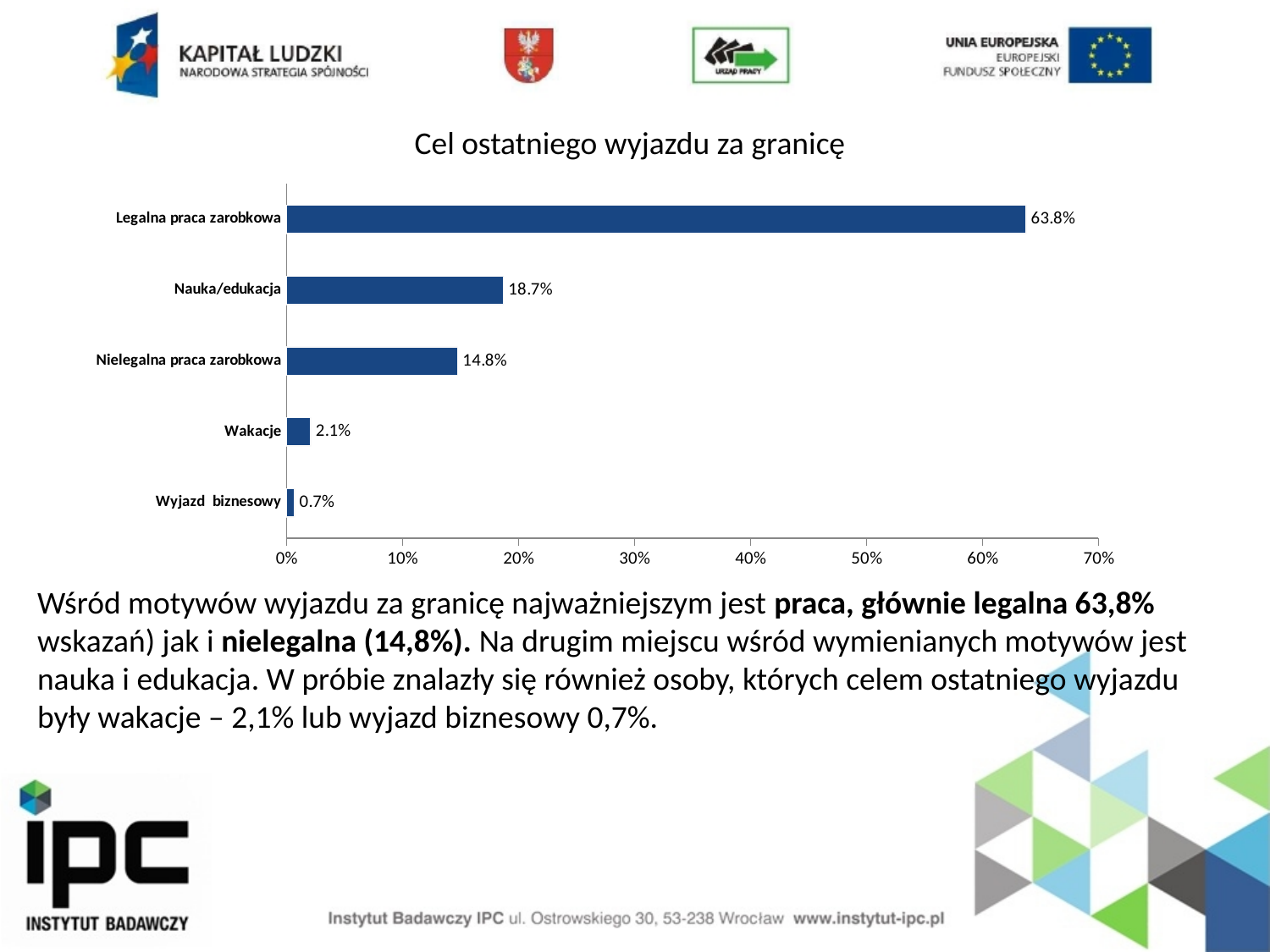
What is the value for Nauka/edukacja? 18.7% What kind of chart is shown? bar chart What is the title of the chart? Cel ostatniego wyjazdu za granicę What is the difference between Nauka/edukacja and Nielegalna praca zarobkowa? 3.9% Is the value for Legalna praca zarobkowa greater or less than 60%? greater Which category has the highest value? Legalna praca zarobkowa How many categories are shown in the chart? 5 What is the value for Legalna praca zarobkowa? 63.8% What is the value for Wakacje? 2.1% Which category has the lowest value? Wyjazd biznesowy Which is larger, Nielegalna praca zarobkowa or Wakacje? Nielegalna praca zarobkowa What is the difference between Legalna praca zarobkowa and Nielegalna praca zarobkowa? 49.0%